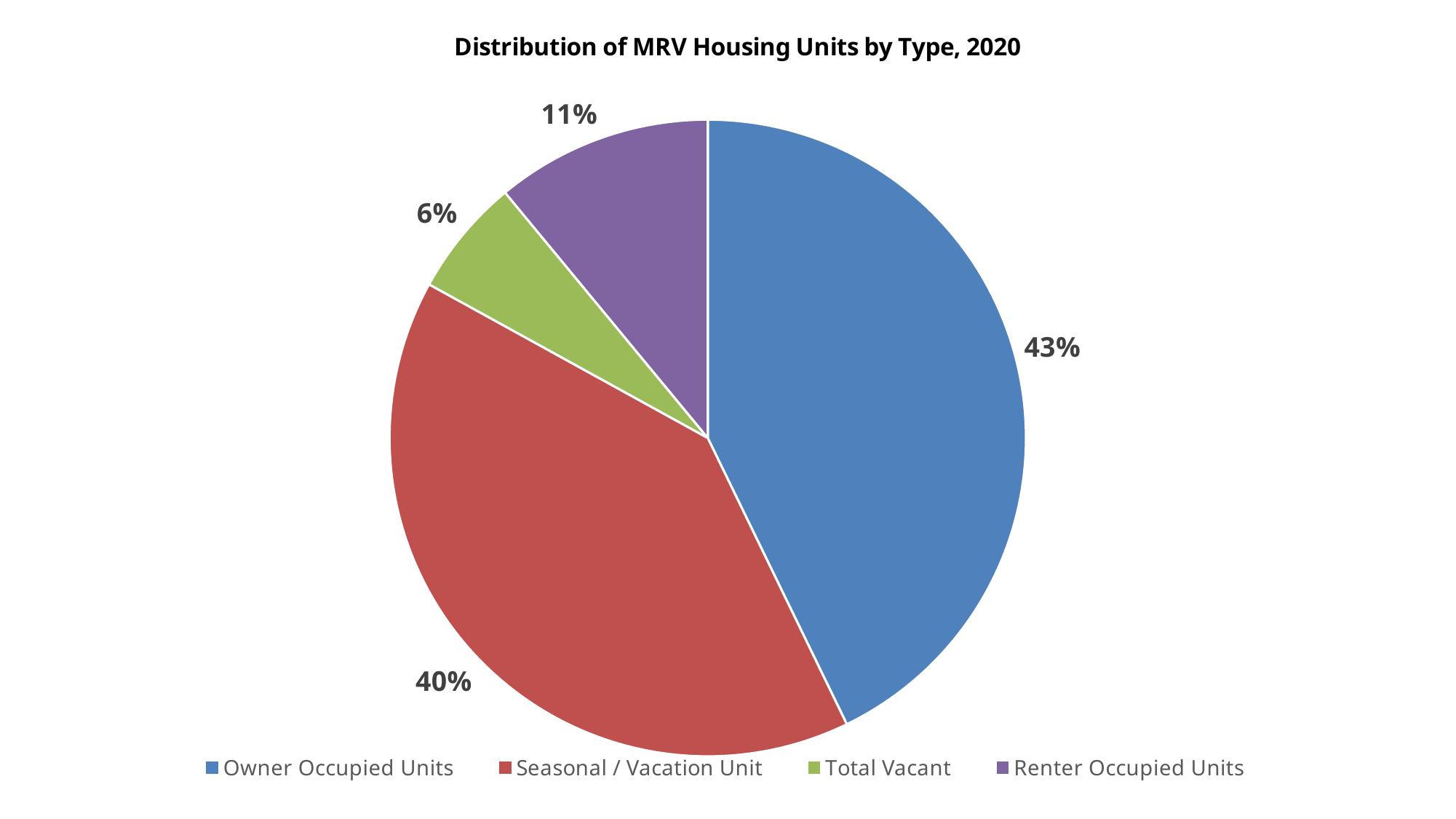
Which is larger, the share for Renter Occupied Units or the share for Total Vacant? Renter Occupied Units What colour is the slice for Seasonal / Vacation Unit? Red How many slices does the pie chart have? 4 What share of MRV housing units are Owner Occupied Units? 43% What is the difference in percentage points between Owner Occupied Units and Renter Occupied Units? 32 What share of MRV housing units are Renter Occupied Units? 11% What is the title of the chart? Distribution of MRV Housing Units by Type, 2020 What share of MRV housing units are Total Vacant? 6% What kind of chart is shown on the slide? Pie chart Which housing unit type has the smallest share of the pie? Total Vacant What share of MRV housing units are Seasonal / Vacation Units? 40% Which housing unit type has the largest share of the pie? Owner Occupied Units